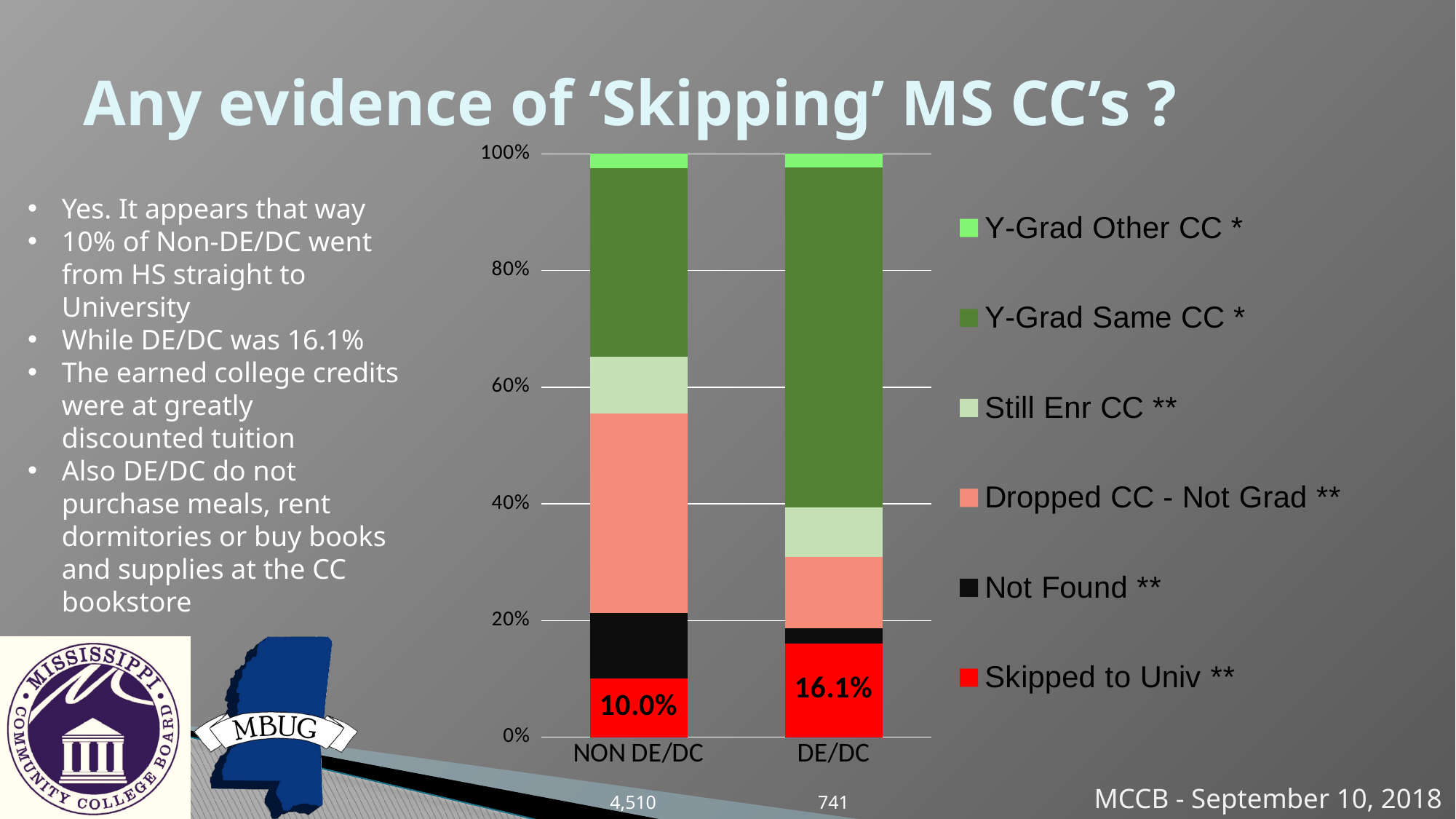
Which category has the larger Y-Grad Same CC segment, NON DE/DC or DE/DC? DE/DC What number is printed below the NON DE/DC bar? 4,510 What kind of chart is shown on the slide? Stacked bar chart What is the value of the Skipped to Univ segment for NON DE/DC? 10.0% What is the difference between the Skipped to Univ values for DE/DC and NON DE/DC? 6.1% How many categories are shown on the x axis of the chart? 2 Is the Dropped CC - Not Grad segment for NON DE/DC greater or less than 20%? greater Which category has the larger Skipped to Univ share, NON DE/DC or DE/DC? DE/DC How many series does the chart legend list? 6 What is the value of the Skipped to Univ segment for DE/DC? 16.1% Which category has the larger Not Found segment, NON DE/DC or DE/DC? NON DE/DC Is the Y-Grad Same CC segment for DE/DC greater or less than 40%? greater